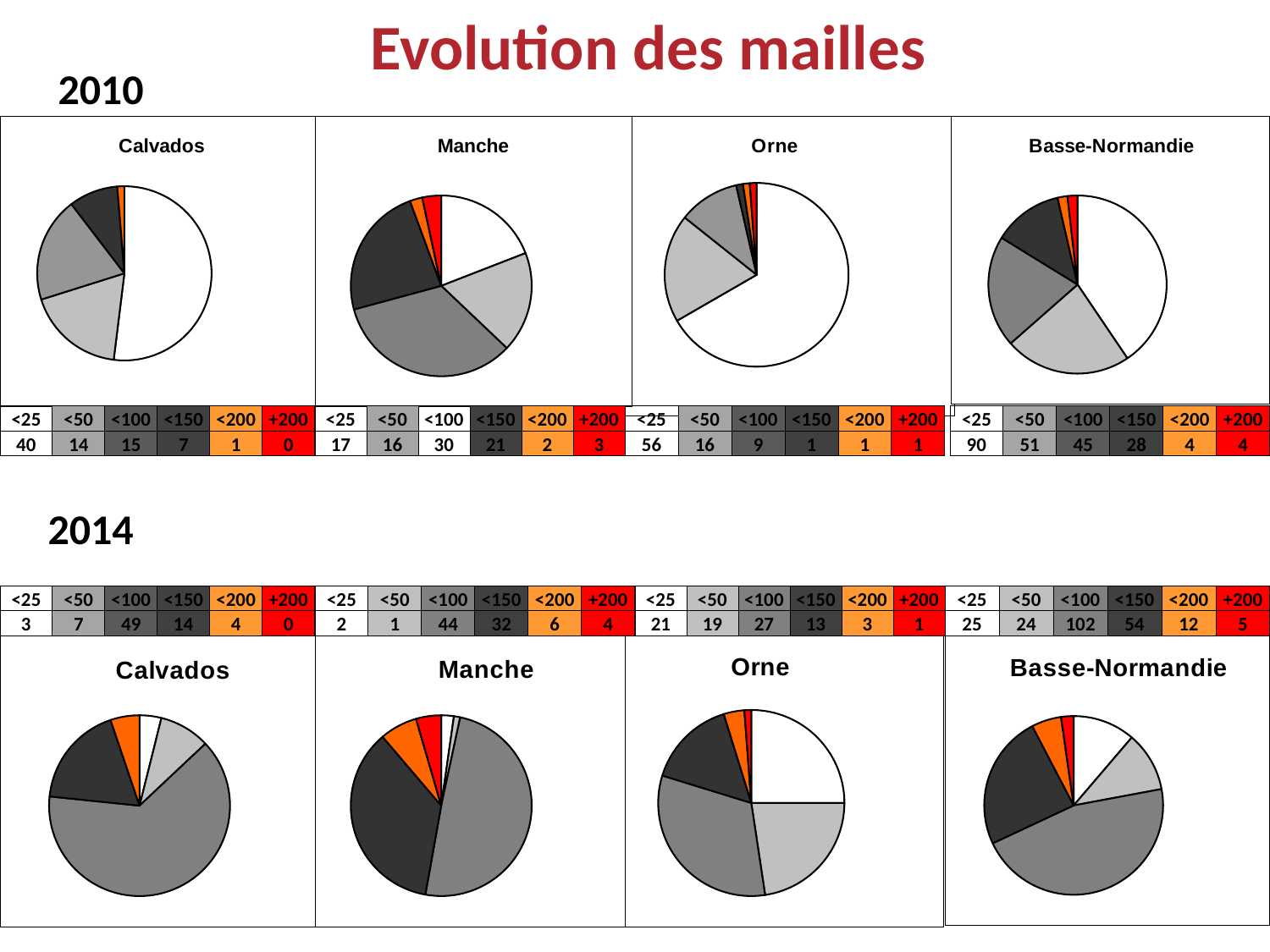
In the 2010 Orne chart, which category has the highest value? <25 What is the title of the slide containing the charts? Evolution des mailles In the 2014 Manche chart, what is the difference between the <100 and <150 values? 12 In the 2014 Calvados chart, which category has the lowest value? +200 In the 2014 Basse-Normandie chart, which is larger, the <150 value or the <25 value? <150 In the 2014 Orne chart, which category has the highest value? <100 In the 2014 Basse-Normandie chart, what is the value for the <100 category? 102 What kind of chart is used for Manche in 2014? pie chart In the 2010 Manche chart, what is the value for the <150 category? 21 In the 2010 Basse-Normandie chart, what is the difference between the <25 and <50 values? 39 How many categories does each pie chart on the slide have? 6 In the 2010 Calvados chart, what is the value for the <25 category? 40